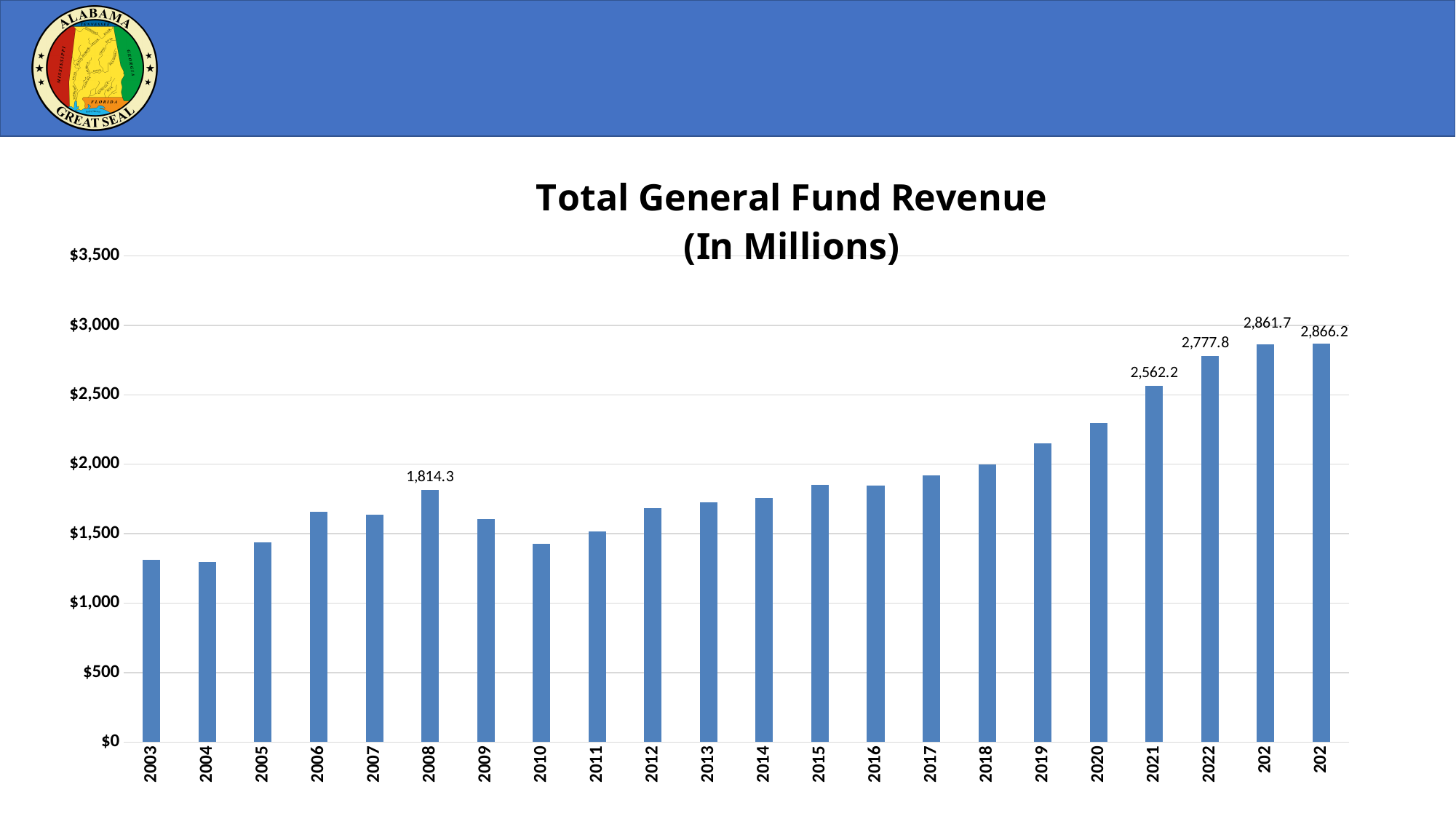
What is the Total General Fund Revenue value shown for 2021? 2,562.2 How many bars are plotted on the chart? 22 What is the Total General Fund Revenue value shown for 2022? 2,777.8 What kind of chart is shown on the slide? bar chart What is the Total General Fund Revenue value shown for 2008? 1,814.3 What value is labelled on the rightmost bar of the chart? 2,866.2 Is the value for 2010 greater or less than $1,500? less Is the value for 2019 greater or less than $2,000? greater What is the highest value printed as a data label on the chart? 2,866.2 What is the difference between the 2021 value and the 2008 value? 747.9 Which year has the larger value, 2008 or 2009? 2008 What is the difference between the 2022 value and the 2021 value? 215.6